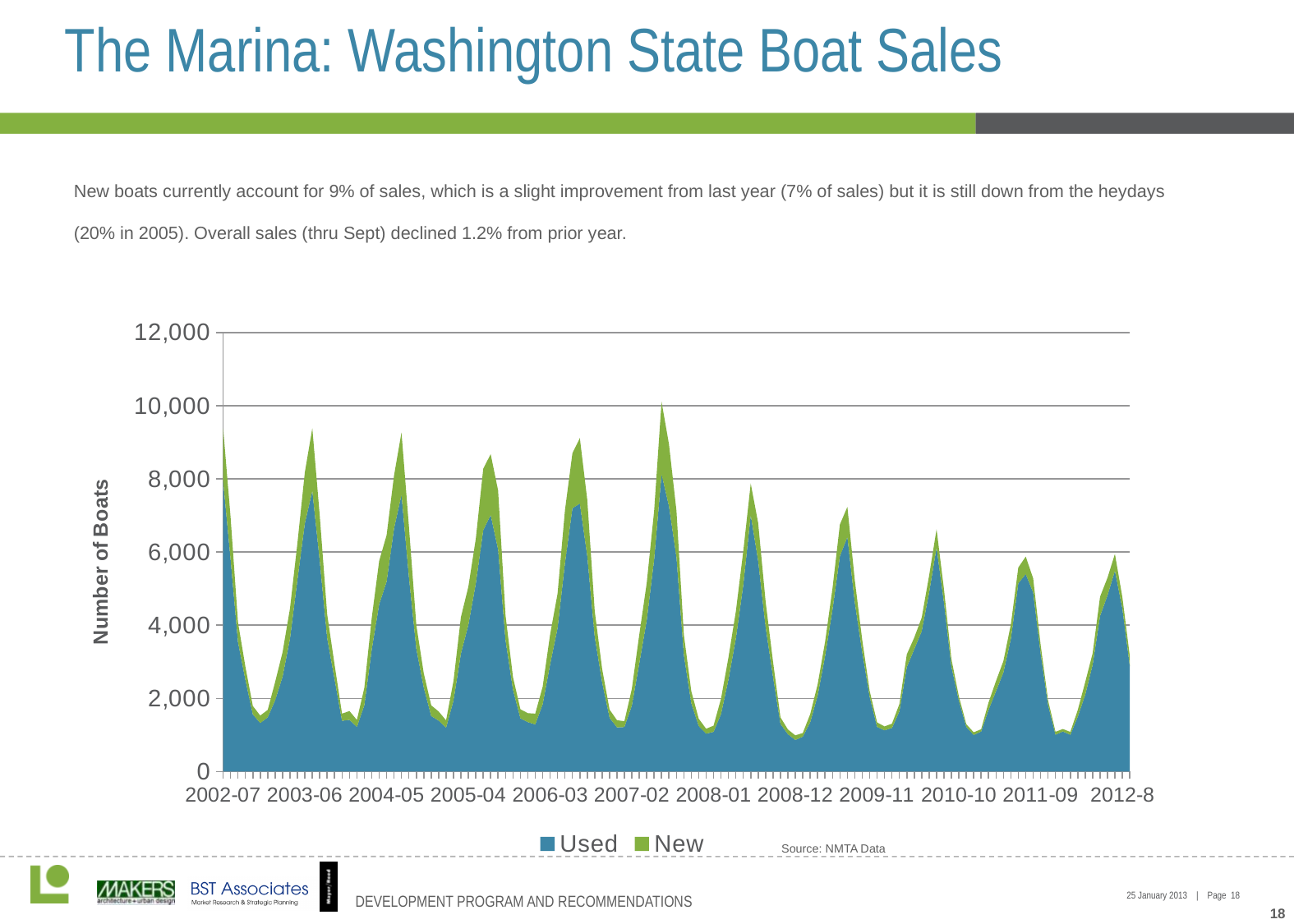
What kind of chart is shown on the slide? Stacked area chart What is the highest value shown on the chart's vertical axis? 12,000 Do the annual peaks of total boat sales generally rise or fall from 2008 to 2012? fall Around which x-axis label does the chart reach its highest peak in total boat sales? 2007-02 Is the highest peak of total boat sales on the chart (around 2008-01) greater or less than 8,000? greater How many labels are shown along the chart's x axis? 12 How many series does the chart's legend list? 2 Are the seasonal low points of total boat sales greater or less than 2,000? less Which series, Used or New, accounts for the larger share of boat sales throughout the chart? Used What is the title of the chart's vertical axis? Number of Boats Is the peak of total boat sales near 2012-8 greater or less than 8,000? less What are the two series named in the chart's legend? Used and New